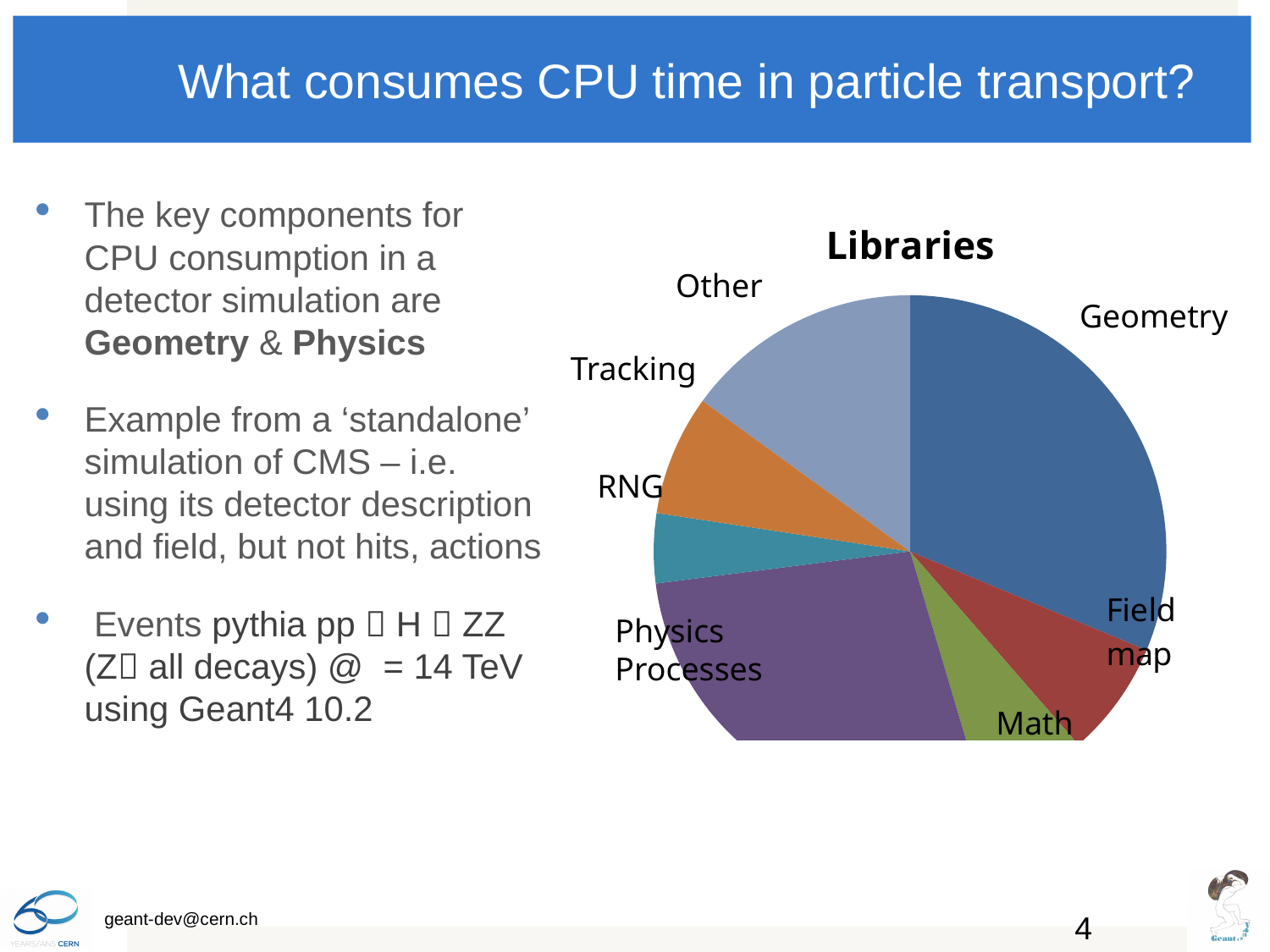
What colour is the Physics Processes slice in the pie chart? purple Which library takes the largest share of the pie chart? Geometry How many slices does the pie chart have? 7 Which slice is larger, Other or RNG? Other Which slice is larger, Physics Processes or Field map? Physics Processes Which slice is larger, Tracking or Math? Tracking What kind of chart is shown on the slide? pie chart What is the title of the pie chart? Libraries